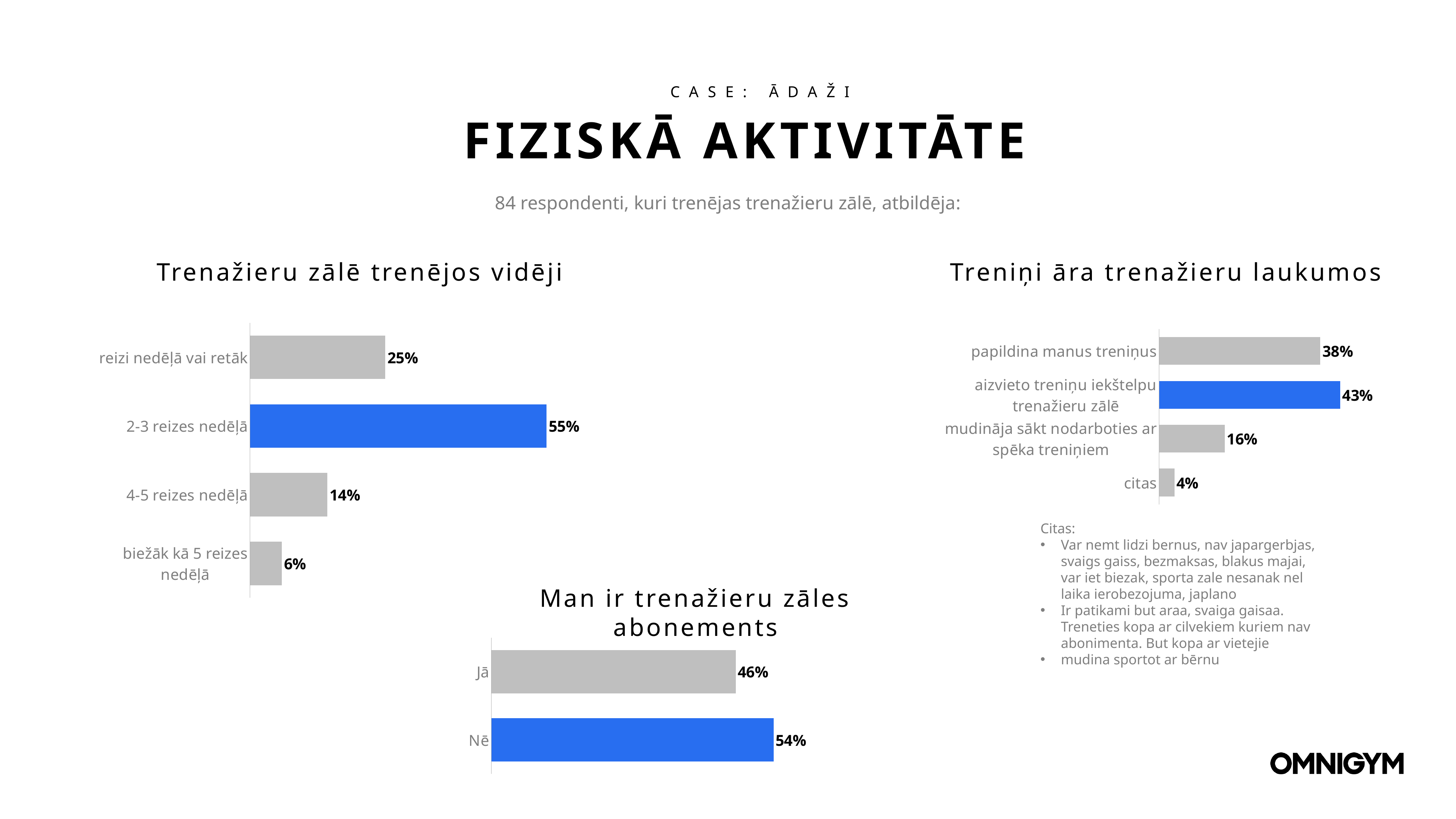
In the 'Man ir trenažieru zāles abonements' chart, what is the difference between 'Nē' and 'Jā'? 8% In the 'Trenažieru zālē trenējos vidēji' chart, what is the value for '2-3 reizes nedēļā'? 55% In the 'Treniņi āra trenažieru laukumos' chart, what is the value for 'papildina manus treniņus'? 38% In the 'Trenažieru zālē trenējos vidēji' chart, which category has the lowest value? biežāk kā 5 reizes nedēļā In the 'Man ir trenažieru zāles abonements' chart, what is the value for 'Nē'? 54% In the 'Treniņi āra trenažieru laukumos' chart, which bar is coloured blue? aizvieto treniņu iekštelpu trenažieru zālē In the 'Trenažieru zālē trenējos vidēji' chart, how many categories are shown? 4 In the 'Trenažieru zālē trenējos vidēji' chart, what is the difference between 'reizi nedēļā vai retāk' and '4-5 reizes nedēļā'? 11% In the 'Treniņi āra trenažieru laukumos' chart, which category has the highest value? aizvieto treniņu iekštelpu trenažieru zālē In the 'Treniņi āra trenažieru laukumos' chart, which is larger: 'mudināja sākt nodarboties ar spēka treniņiem' or 'citas'? mudināja sākt nodarboties ar spēka treniņiem What kind of chart is 'Man ir trenažieru zāles abonements'? Bar chart In the 'Treniņi āra trenažieru laukumos' chart, what is the value for 'citas'? 4%